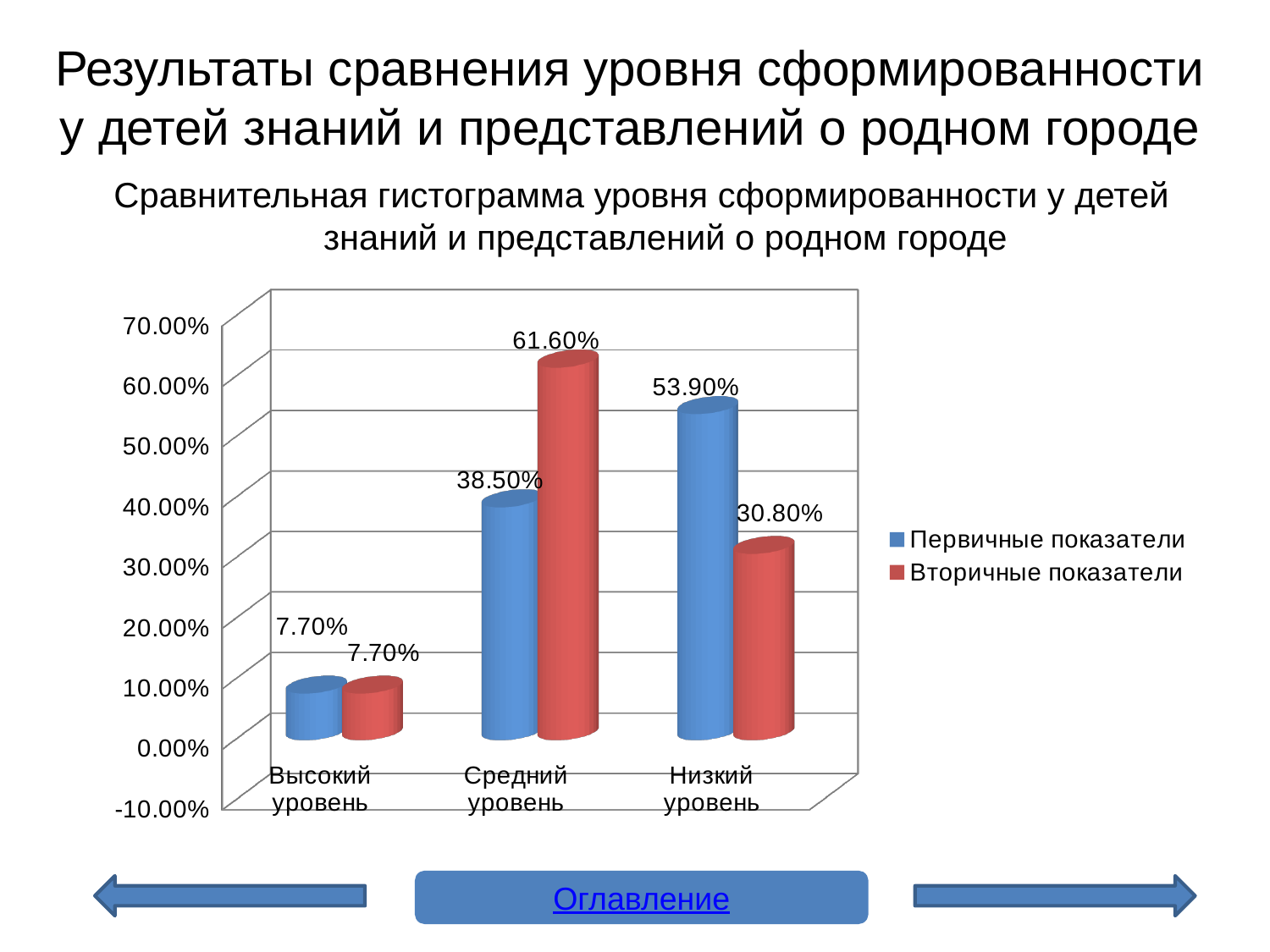
Which category has the lowest value for Первичные показатели? Высокий уровень Is the value of Первичные показатели for Низкий уровень greater or less than 50.00%? greater What is the difference between Вторичные показатели and Первичные показатели for Средний уровень? 23.10% What is the value of Первичные показатели for Средний уровень? 38.50% What is the value of Вторичные показатели for Высокий уровень? 7.70% What kind of chart is shown on the slide? Bar chart For Низкий уровень, which series has the larger value: Первичные показатели or Вторичные показатели? Первичные показатели What colour are the bars for Вторичные показатели? Red Which category has the highest value for Вторичные показатели? Средний уровень What is the value of Вторичные показатели for Низкий уровень? 30.80% How many categories are shown on the x axis? 3 How many series does the legend list? 2